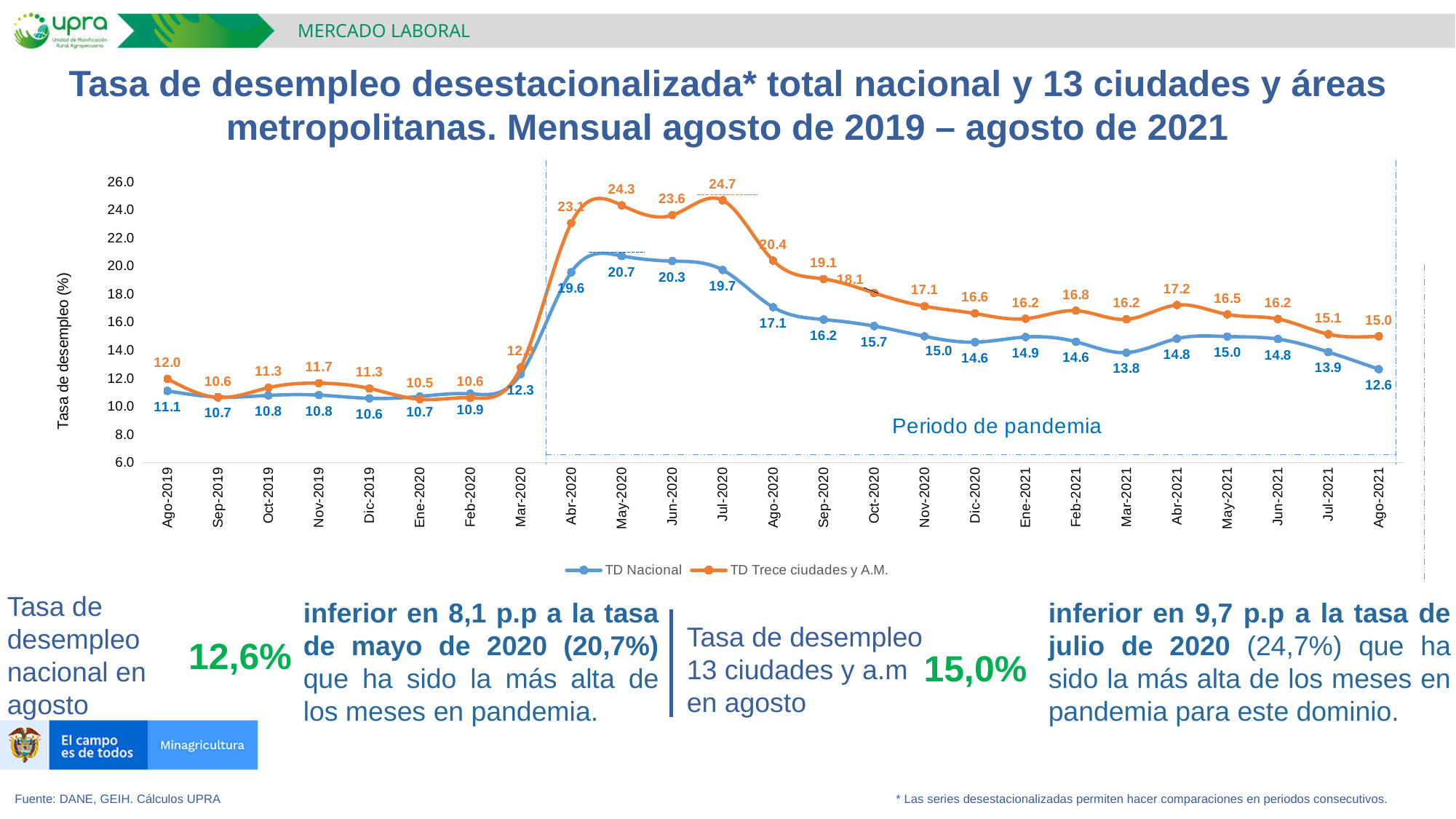
In which month is TD Nacional at its lowest value? Dic-2019 What is the value of TD Trece ciudades y A.M. in Jul-2020? 24.7 In which month is TD Trece ciudades y A.M. at its lowest value? Ene-2020 What is the difference between TD Nacional in May-2020 and in Ago-2021? 8.1 In which month does TD Nacional reach its highest value? May-2020 In which month does TD Trece ciudades y A.M. reach its highest value? Jul-2020 How many series does the legend list? 2 In Ago-2019, which series has the higher value, TD Nacional or TD Trece ciudades y A.M.? TD Trece ciudades y A.M. What is the value of TD Nacional in Ago-2021? 12.6 What kind of chart is shown on the slide? Line chart What is the difference between TD Trece ciudades y A.M. in Jul-2020 and in Ago-2021? 9.7 What is the value of TD Nacional in Mar-2021? 13.8